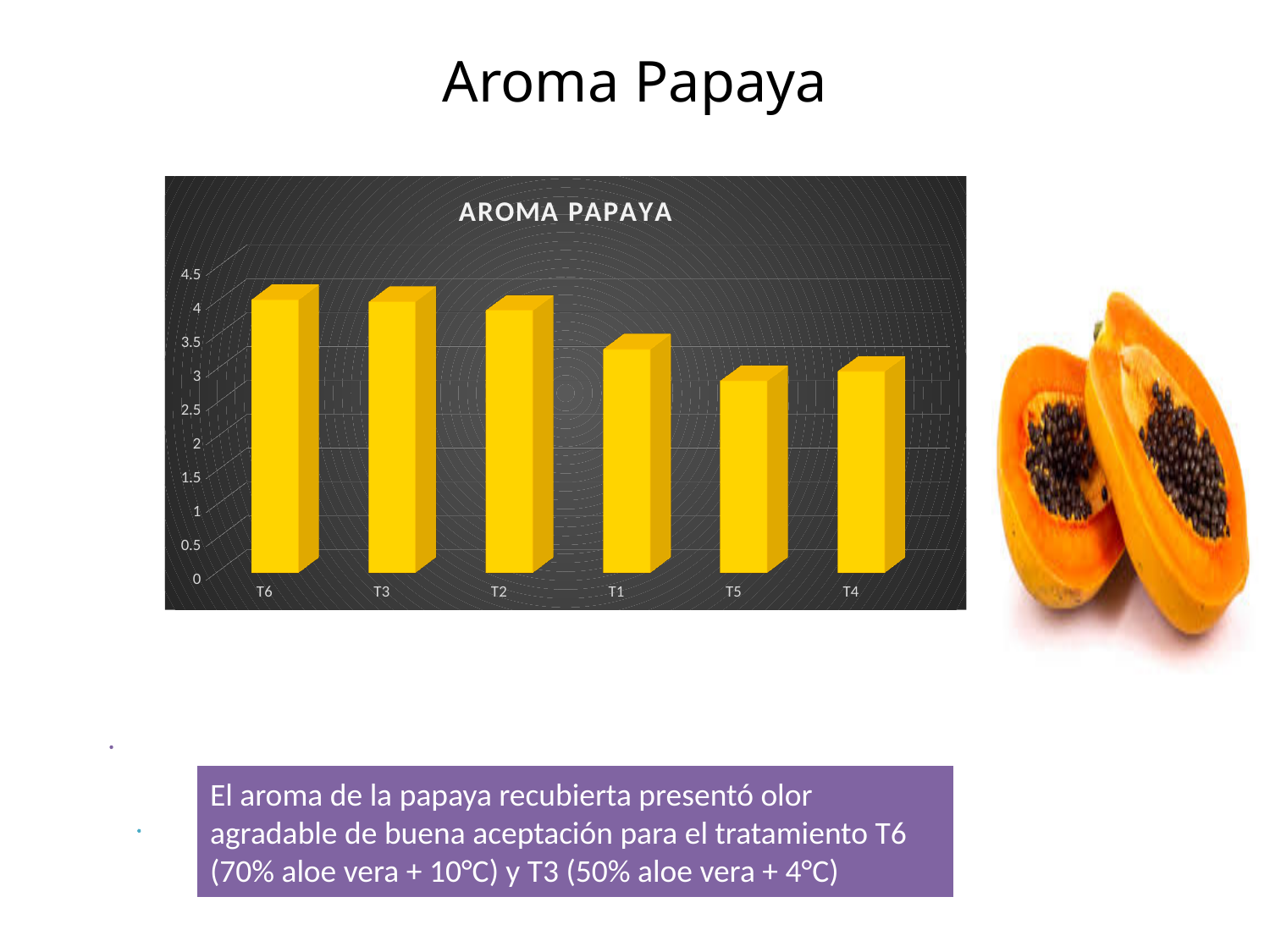
Is the value for T6 greater or less than 3.5? greater Is the value for T2 greater or less than 3? greater What colour are the bars in the chart? yellow Is the value for T5 greater or less than 3.5? less What is the title of the chart? AROMA PAPAYA Do the bar values generally rise or fall from left to right along the x axis? fall How many treatment categories are shown on the x axis of the chart? 6 Which has the larger value, T2 or T5? T2 What type of chart is shown on the slide? bar chart Which has the larger value, T6 or T1? T6